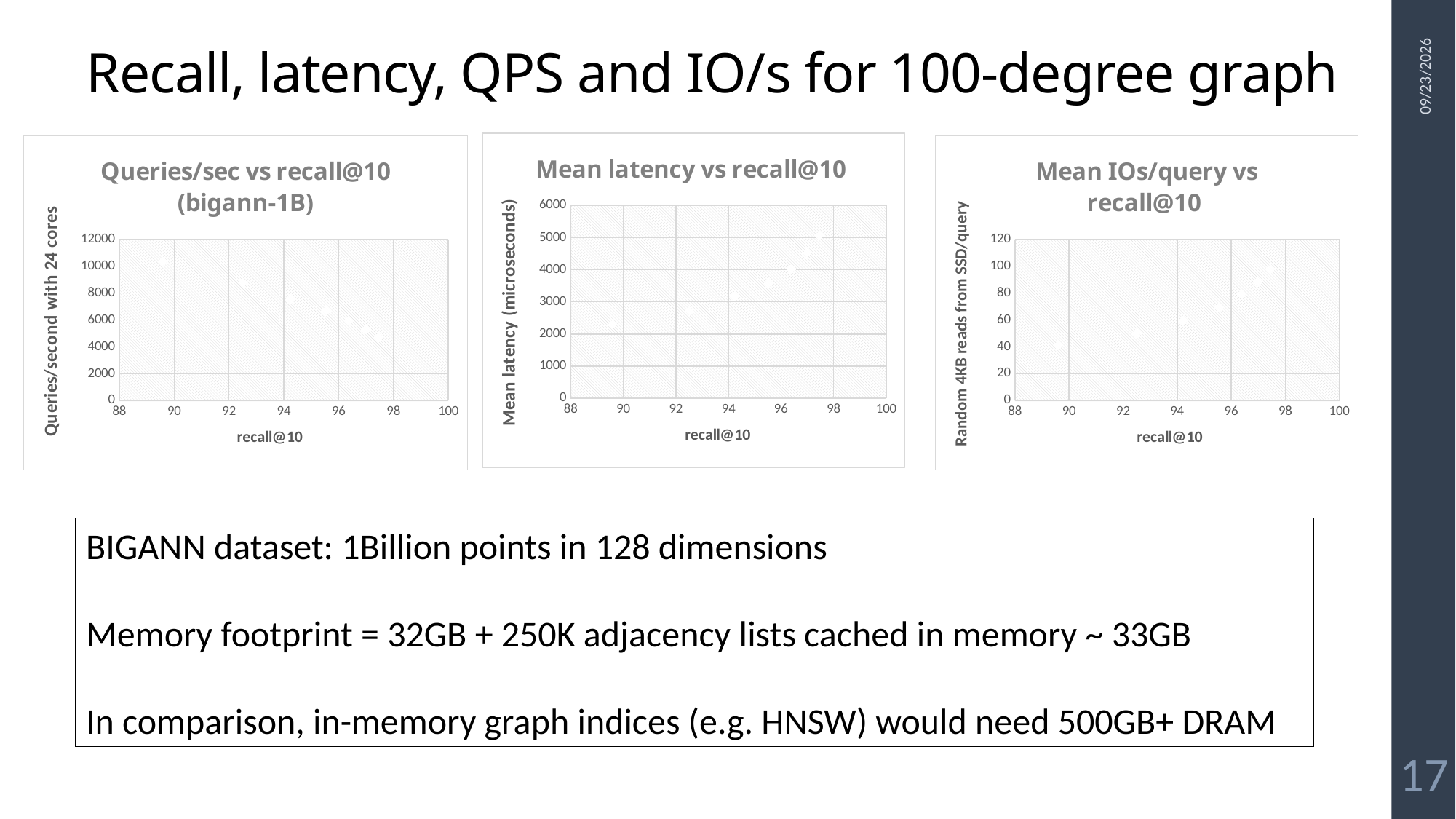
In the 'Mean IOs/query vs recall@10' chart, is the IOs/query value at the lowest recall@10 point greater or less than 60? less In the 'Mean latency vs recall@10' chart, do the latency values rise or fall as recall@10 increases? rise What kind of chart is the 'Queries/sec vs recall@10 (bigann-1B)' chart? scatter chart In the 'Mean IOs/query vs recall@10' chart, do the IOs/query values rise or fall as recall@10 increases? rise What is the y-axis label of the 'Mean IOs/query vs recall@10' chart? Random 4KB reads from SSD/query In the 'Mean latency vs recall@10' chart, is the latency at the lowest recall@10 point greater or less than 3000? less What is the x-axis label shared by all three charts on the slide? recall@10 In the 'Queries/sec vs recall@10 (bigann-1B)' chart, is the queries/sec value at the lowest recall@10 point greater or less than 8000? greater In the 'Queries/sec vs recall@10 (bigann-1B)' chart, do the queries/sec values rise or fall as recall@10 increases? fall